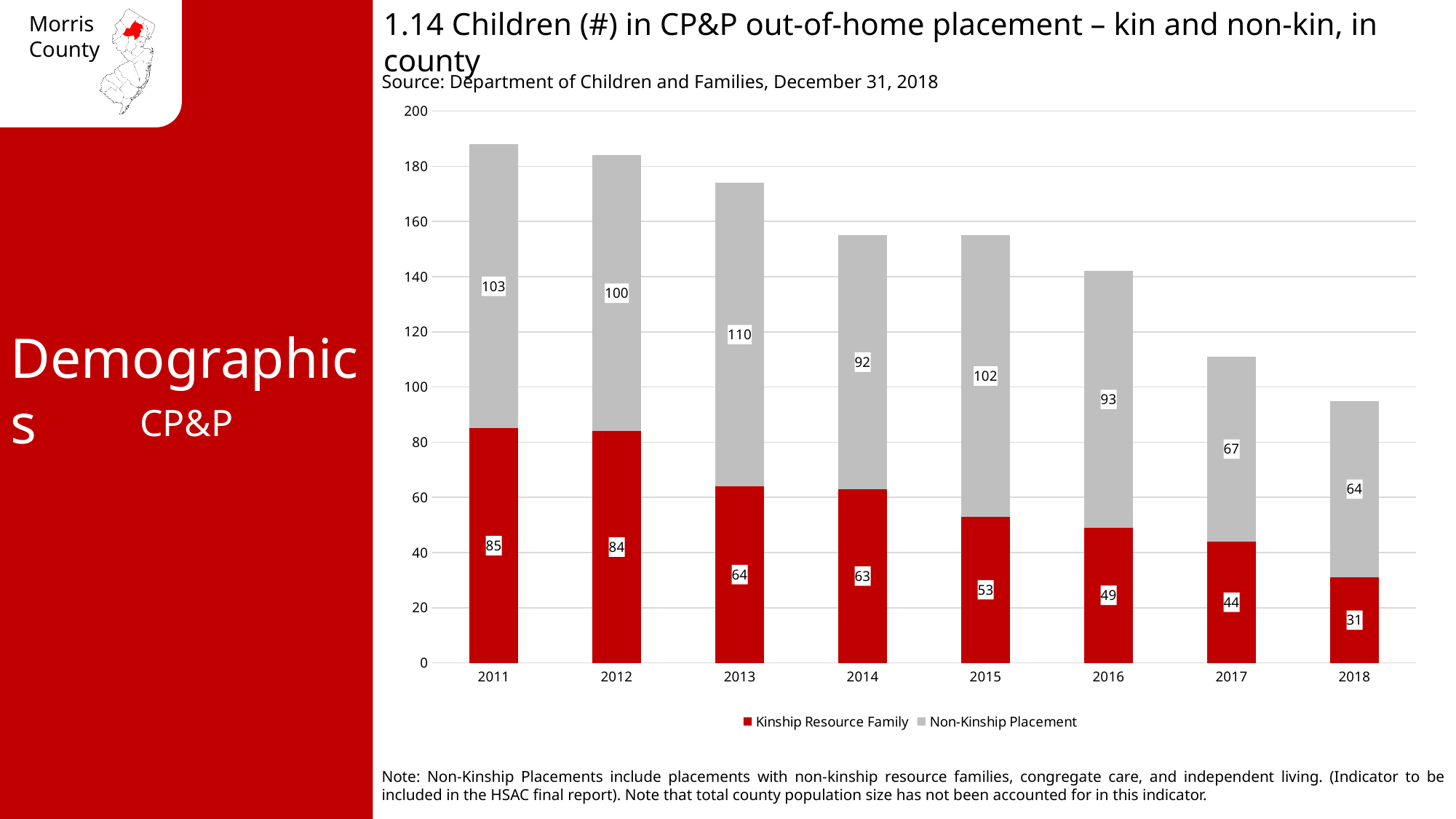
Which year has the highest Non-Kinship Placement value? 2013 What is the Kinship Resource Family value for 2011? 85 What kind of chart is shown on the slide? Stacked bar chart How many years are shown on the x axis? 8 How many series does the legend list? 2 What is the total of the stacked bar for 2017? 111 Which year has the lowest Kinship Resource Family value? 2018 Which is larger, the Kinship Resource Family value for 2015 or for 2016? 2015 What is the total of the stacked bar for 2011? 188 What is the Non-Kinship Placement value for 2013? 110 What is the Kinship Resource Family value for 2018? 31 What is the difference between the Non-Kinship Placement values for 2011 and 2018? 39